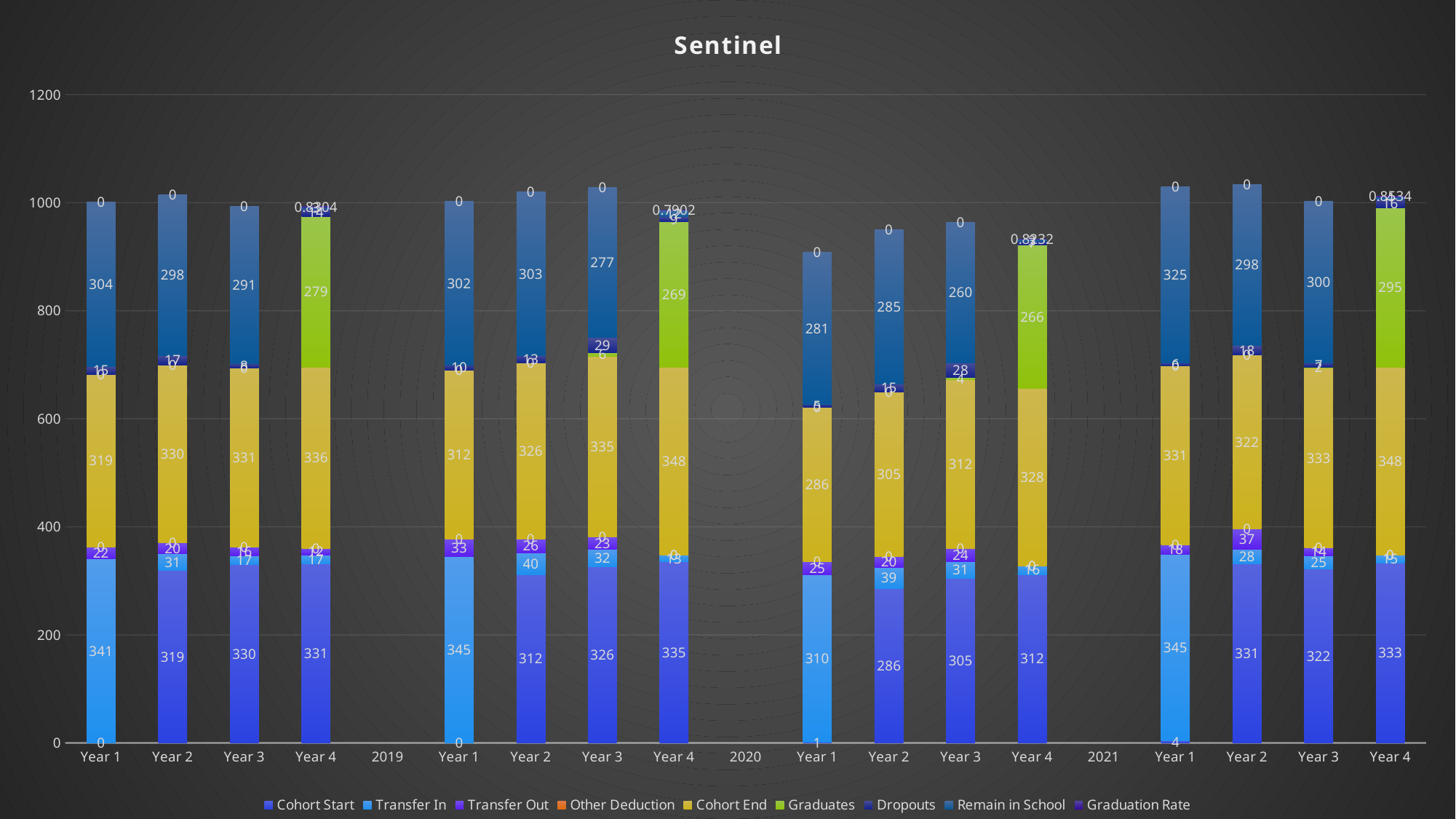
Which series is shown in green in the legend? Graduates How many series does the legend list? 9 Which Year 4 bar has the highest Graduates value? The rightmost Year 4 bar (after the 2021 label) Which is larger: the Graduates value in the leftmost Year 4 bar or in the Year 4 bar between the 2019 and 2020 labels? The leftmost Year 4 bar (279) What is the title of the chart? Sentinel What type of chart is shown on the slide? Stacked bar chart What is the difference between the highest Graduates value (295) and the lowest Graduates value (266)? 29 How many Year 4 bars are plotted on the chart? 4 What is the Graduates value for the rightmost Year 4 bar (the group after the 2021 label)? 295 Which Year 4 bar has the lowest Graduates value? The Year 4 bar between the 2020 and 2021 labels What is the Graduates value for the leftmost Year 4 bar (the group before the 2019 label)? 279 What is the Cohort End value for the leftmost Year 1 bar? 319